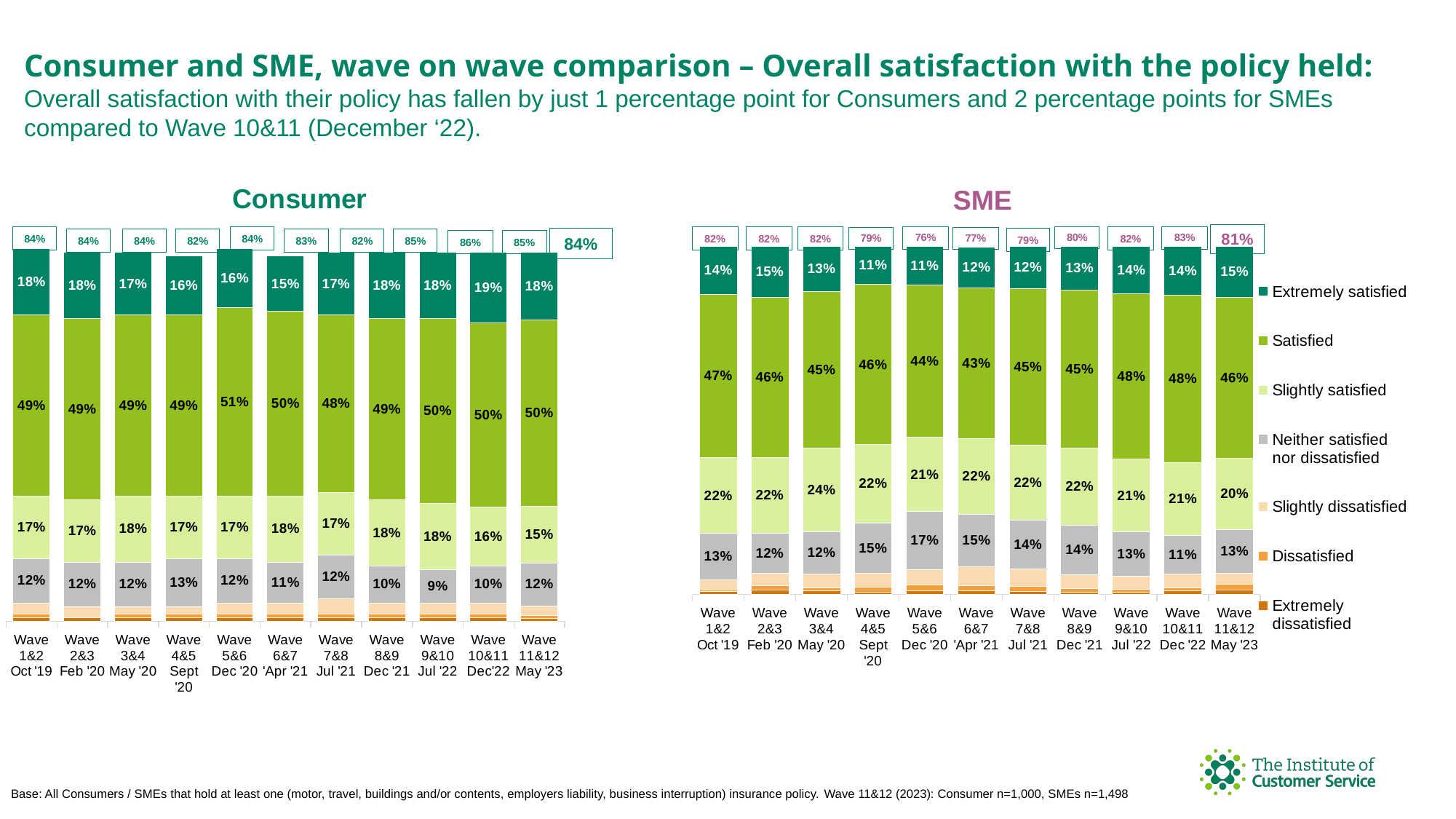
Which legend entry is shown in the darkest green colour? Extremely satisfied On the Consumer chart, what is the 'Slightly satisfied' percentage in Wave 11&12 (May '23)? 15% On the Consumer chart, what percentage of respondents were 'Satisfied' in Wave 5&6 (Dec '20)? 51% How many waves are plotted on the SME chart? 11 How many series does the legend list? 7 On the Consumer chart, which is larger: the 'Extremely satisfied' share in Wave 10&11 (Dec '22) or in Wave 6&7 (Apr '21)? Wave 10&11 Dec '22 On the SME chart, what percentage of respondents were 'Neither satisfied nor dissatisfied' in Wave 5&6 (Dec '20)? 17% On the SME chart, what is the difference between the 'Satisfied' percentage in Wave 9&10 (Jul '22) and in Wave 6&7 (Apr '21)? 5% What type of chart is the Consumer chart? Stacked bar chart On the Consumer chart, which wave has the highest boxed overall satisfaction figure? Wave 9&10 Jul '22 On the SME chart, what is the overall satisfaction figure shown in the box above Wave 11&12 (May '23)? 81% On the SME chart, which wave has the lowest boxed overall satisfaction figure? Wave 5&6 Dec '20